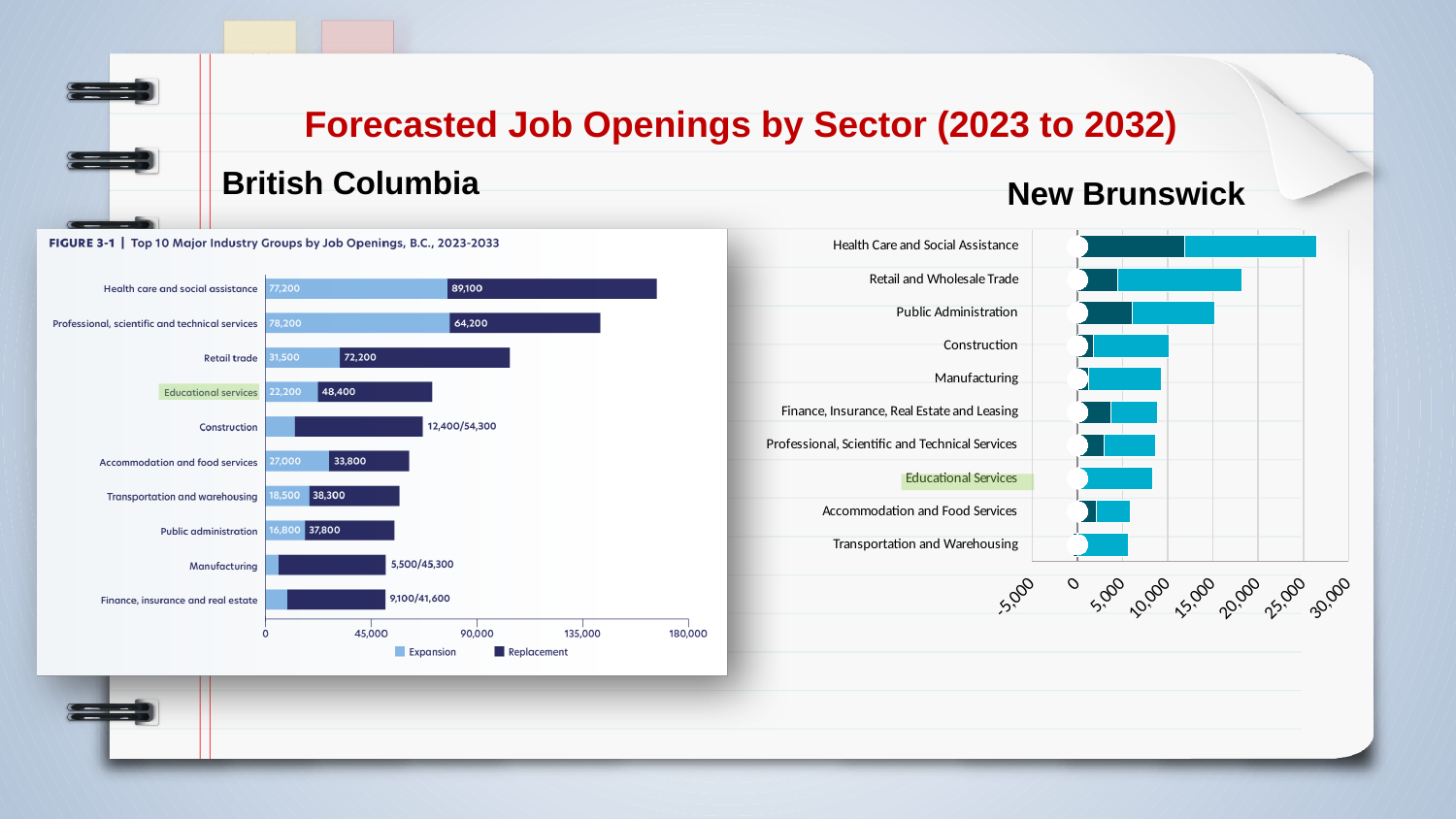
How many sectors are shown on the New Brunswick chart? 10 What kind of chart is the New Brunswick chart? bar chart On the British Columbia chart, which is larger: the Replacement value for Transportation and warehousing or for Public administration? Transportation and warehousing On the British Columbia chart, what is the Replacement value for Health care and social assistance? 89,100 On the British Columbia chart, what is the Expansion value for Professional, scientific and technical services? 78,200 On the British Columbia chart, what is the difference between the Replacement values for Health care and social assistance and Retail trade? 16,900 On the New Brunswick chart, is the total value for Health Care and Social Assistance greater or less than 20,000? greater How many series does the legend on the British Columbia chart list? 2 On the British Columbia chart, what is the Replacement value for Retail trade? 72,200 On the British Columbia chart, what is the total of the stacked bar for Accommodation and food services? 60,800 On the British Columbia chart, what is the Expansion value for Educational services? 22,200 On the British Columbia chart, which industry group has the lowest Expansion value? Manufacturing